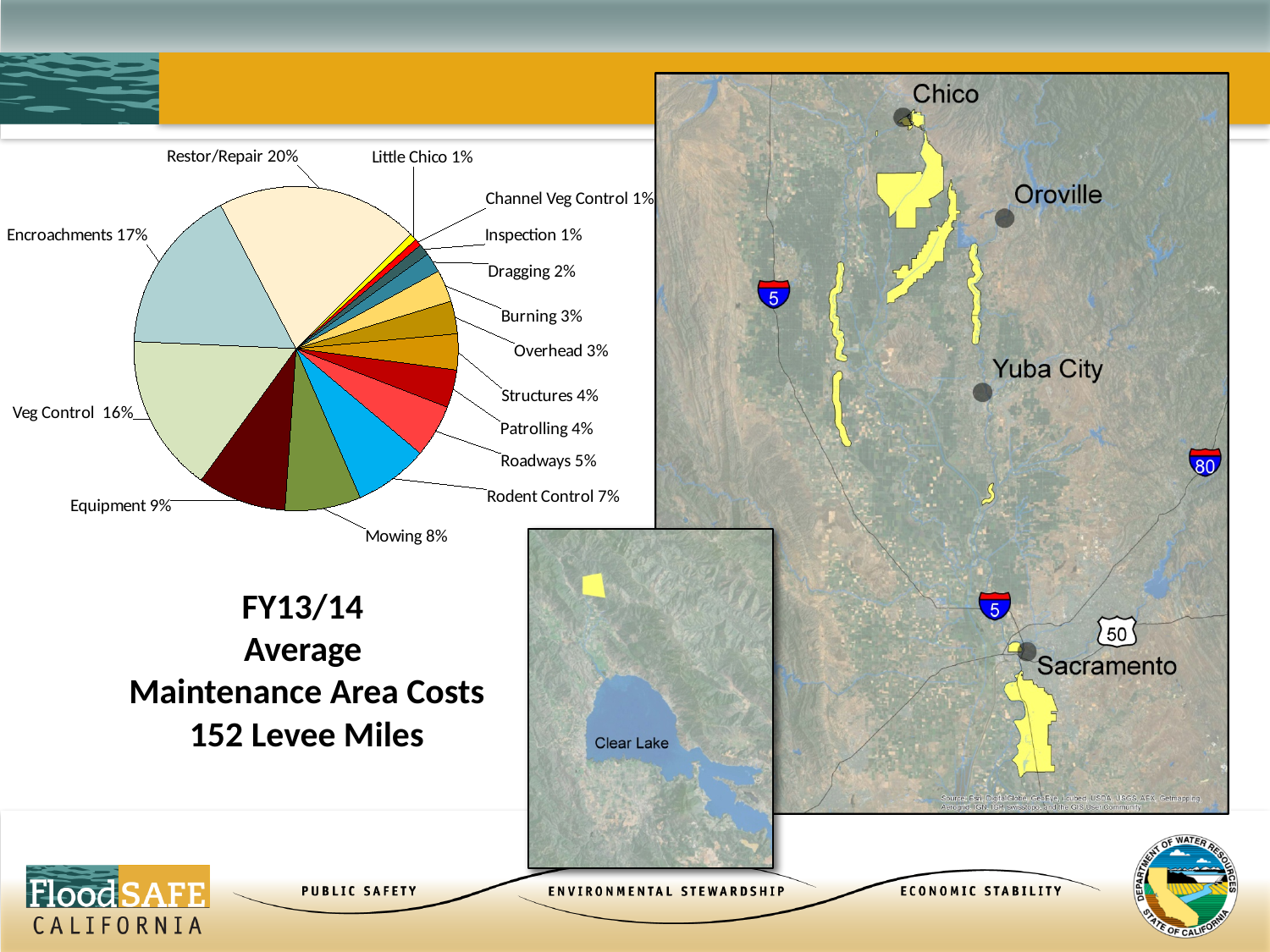
What is the value shown for Dragging? 2% What is the difference in percentage points between Encroachments and Veg Control? 1% Which category has the largest share of the pie? Restor/Repair What is the value shown for Encroachments? 17% What is the value shown for Rodent Control? 7% What fiscal year does the chart's title say the maintenance area costs are for? FY13/14 What kind of chart is shown on the slide? pie chart What is the difference in percentage points between Restor/Repair and Rodent Control? 13% Which is larger, Equipment or Mowing? Equipment What is the value shown for Mowing? 8% What share of the pie does Restor/Repair account for? 20% How many categories are shown in the pie chart? 15